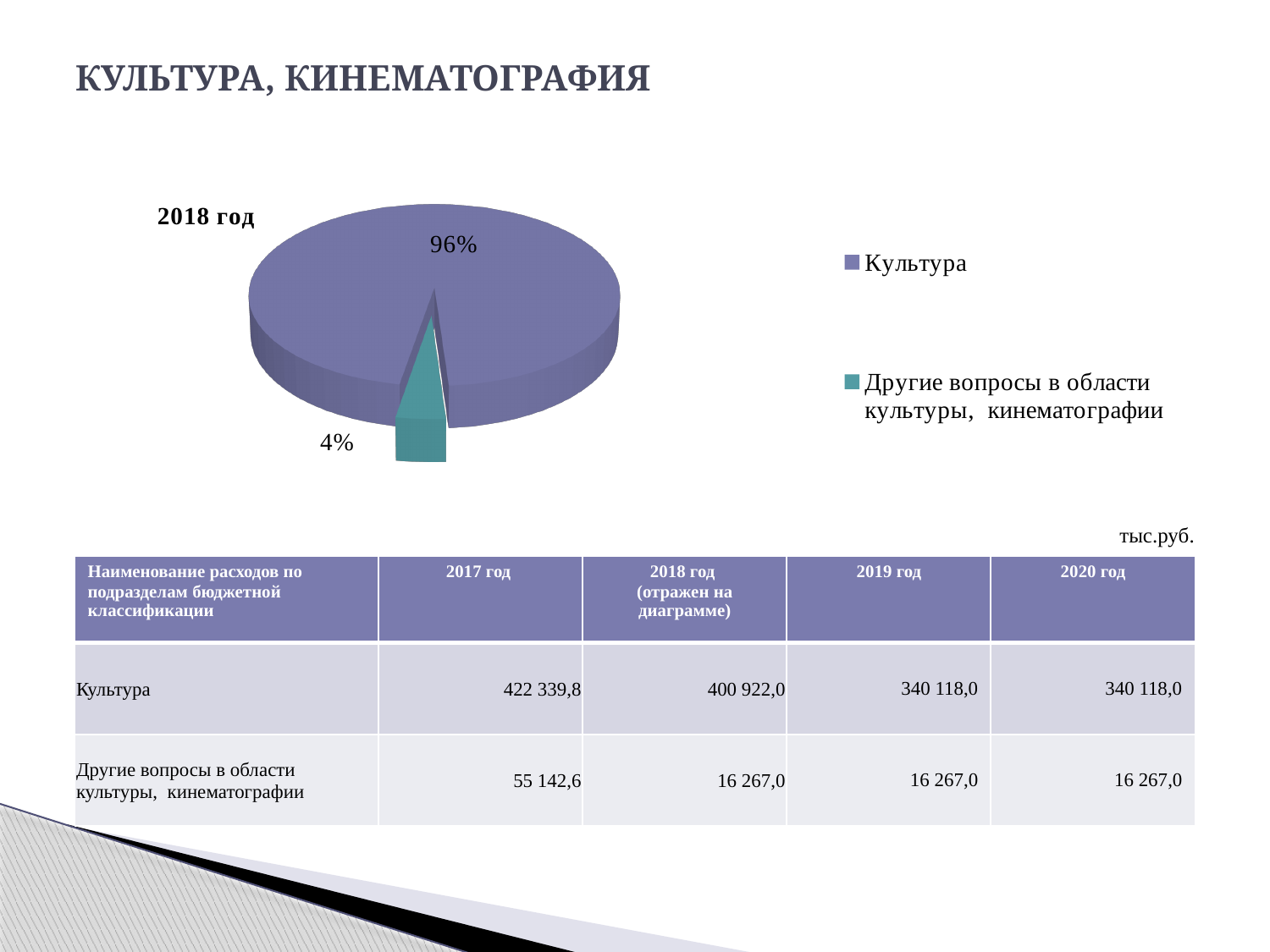
How many entries does the legend of the pie chart list? 2 Which category has the smallest slice in the pie chart? Другие вопросы в области культуры, кинематографии What colour is the slice for Другие вопросы в области культуры, кинематографии in the pie chart? teal (green) Which year does the pie chart represent, according to its label? 2018 год By how many percentage points does the Культура slice exceed the Другие вопросы в области культуры, кинематографии slice? 92 What share of the pie does the slice for Другие вопросы в области культуры, кинематографии represent? 4% What share of the pie does the slice for Культура represent? 96% Which category has the largest slice in the pie chart? Культура Which slice is larger: Культура or Другие вопросы в области культуры, кинематографии? Культура How many slices does the pie chart have? 2 What kind of chart is shown on the slide? pie chart